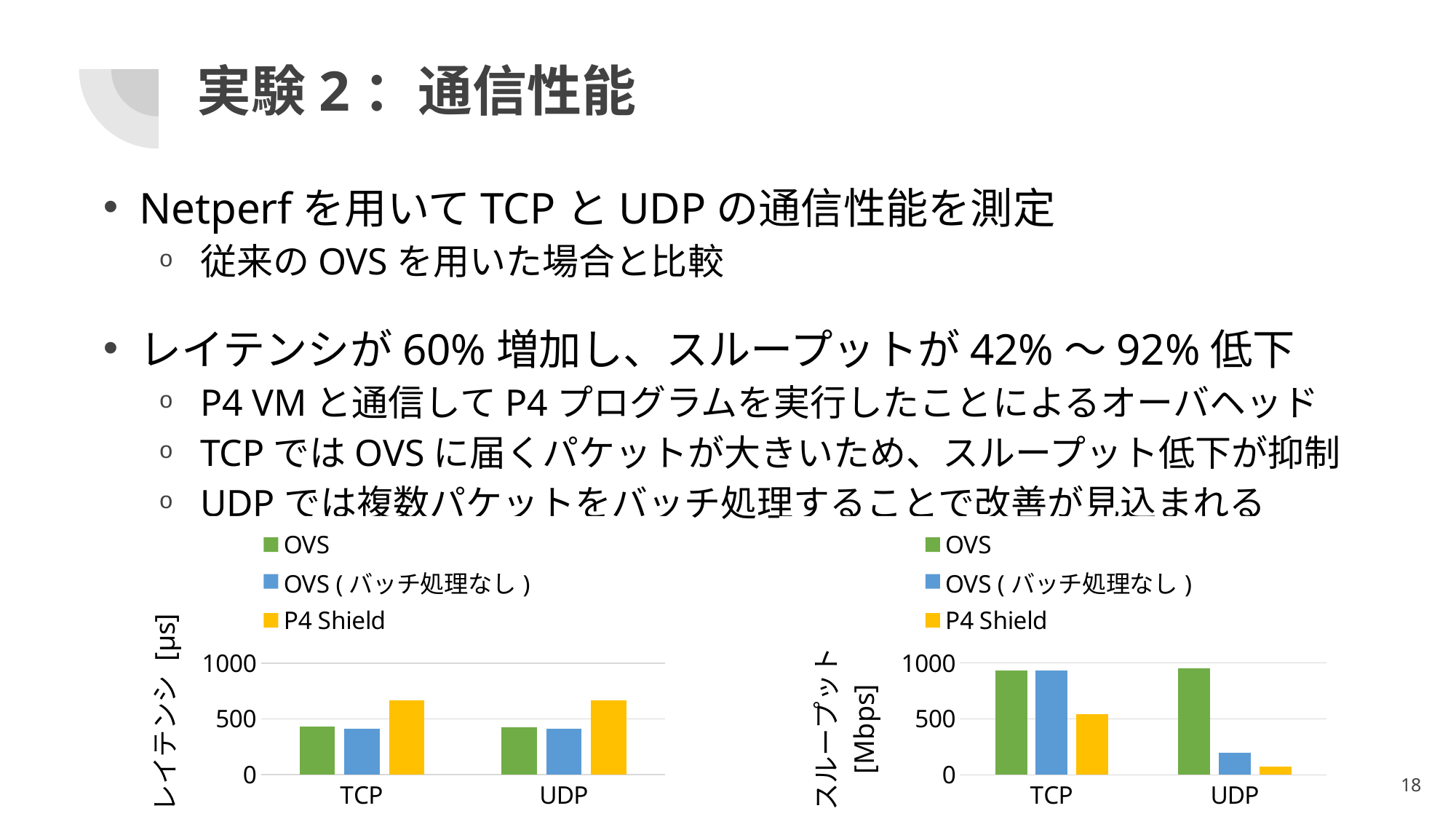
In the right chart (throughput), which series has the lowest value for UDP? P4 Shield What unit is shown on the y axis label of the right chart (throughput)? Mbps In the left chart (latency), which series has the highest value for TCP? P4 Shield In the right chart (throughput), is the P4 Shield value for UDP greater or less than 500? less How many categories are shown on the x axis of the left chart (latency)? 2 In the right chart (throughput), which is larger: the P4 Shield value for TCP or the P4 Shield value for UDP? TCP In the right chart (throughput), which is larger for TCP: the OVS value or the P4 Shield value? OVS In the left chart (latency), is the OVS value for UDP greater or less than 500? less In the right chart (throughput), is the OVS value for UDP greater or less than 500? greater How many series does the legend of the right chart (throughput) list? 3 What kind of chart is the left chart (latency)? bar chart